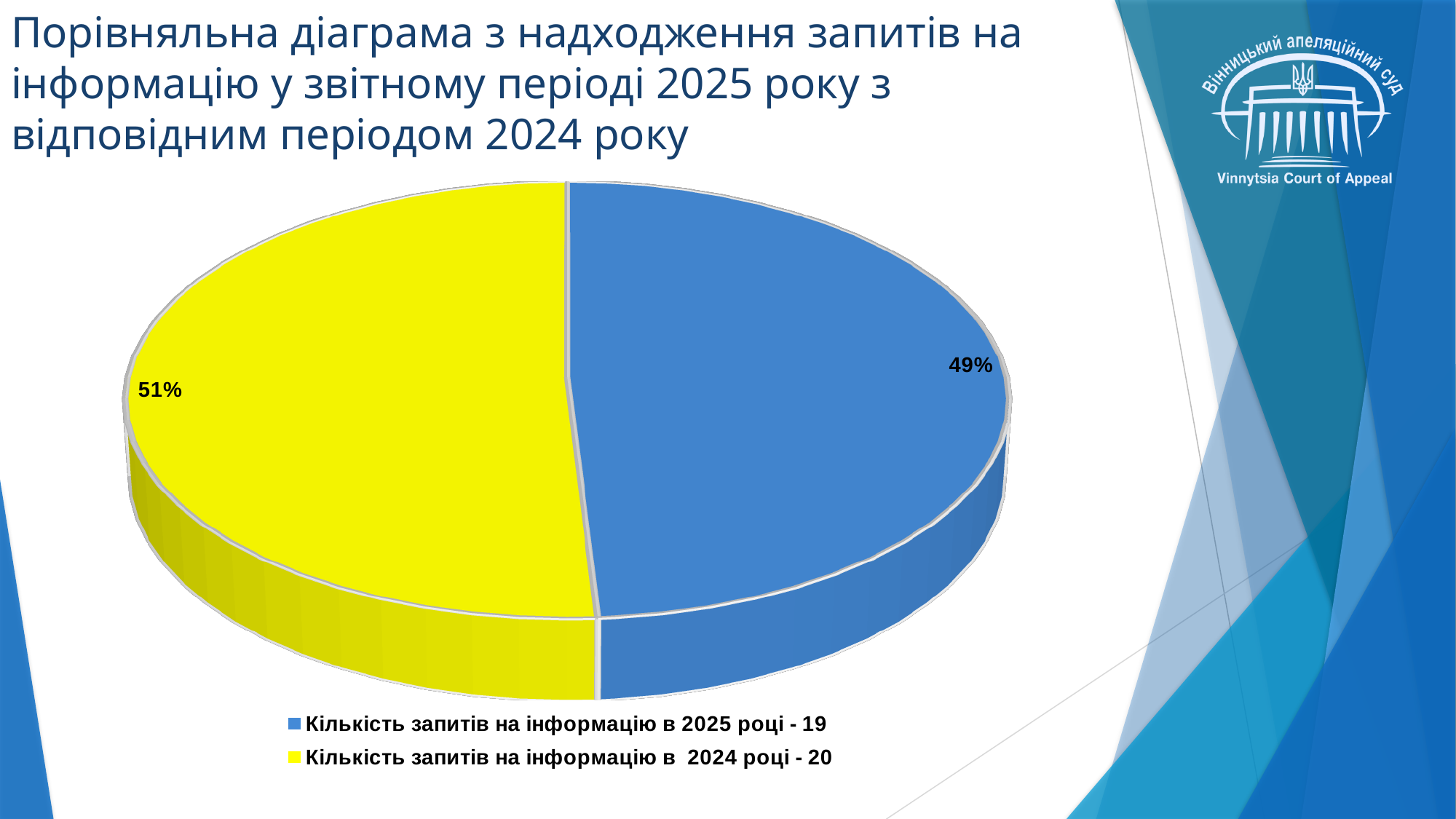
How many entries does the legend list? 2 What is the difference between the number of requests in 2024 and in 2025? 1 What type of chart is shown on the slide? pie chart Which year has the larger slice of the pie, 2024 or 2025? 2024 How many requests for information were received in 2024 according to the legend? 20 What percentage share does the slice for requests for information in 2025 have? 49% What colour is the slice representing requests for information in 2024? yellow How many requests for information were received in 2025 according to the legend? 19 Which slice of the pie is the largest? Кількість запитів на інформацію в 2024 році - 20 What percentage share does the slice for requests for information in 2024 have? 51% How many slices does the pie chart have? 2 Which slice of the pie is the smallest? Кількість запитів на інформацію в 2025 році - 19